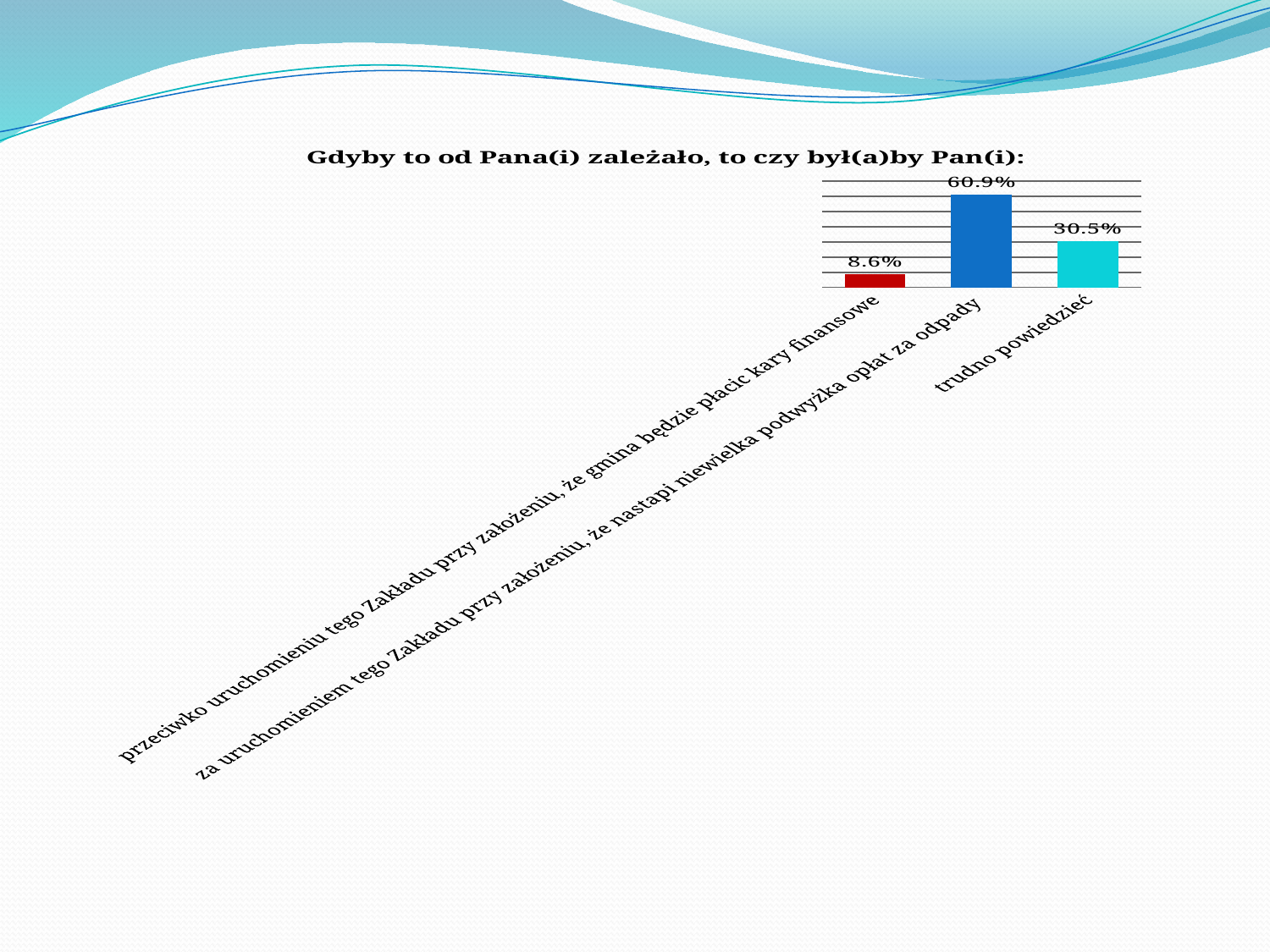
What is the value for the category "za uruchomieniem tego Zakładu przy założeniu, że nastąpi niewielka podwyżka opłat za odpady"? 60.9% What colour is the bar for "przeciwko uruchomieniu tego Zakładu..."? red What is the value for "trudno powiedzieć"? 30.5% Which is larger: the value for "trudno powiedzieć" or the value for "przeciwko uruchomieniu tego Zakładu..."? trudno powiedzieć Which category has the lowest value? przeciwko uruchomieniu tego Zakładu przy założeniu, że gmina będzie płacić kary finansowe What is the difference between the value for "trudno powiedzieć" and the value for "przeciwko uruchomieniu tego Zakładu..."? 21.9% What is the difference between the value for "za uruchomieniem tego Zakładu..." and the value for "trudno powiedzieć"? 30.4% What kind of chart is shown on the slide? bar chart What is the title of the chart? Gdyby to od Pana(i) zależało, to czy był(a)by Pan(i): What is the value for the category "przeciwko uruchomieniu tego Zakładu przy założeniu, że gmina będzie płacić kary finansowe"? 8.6% Which category has the highest value? za uruchomieniem tego Zakładu przy założeniu, że nastąpi niewielka podwyżka opłat za odpady How many categories are shown in the chart? 3